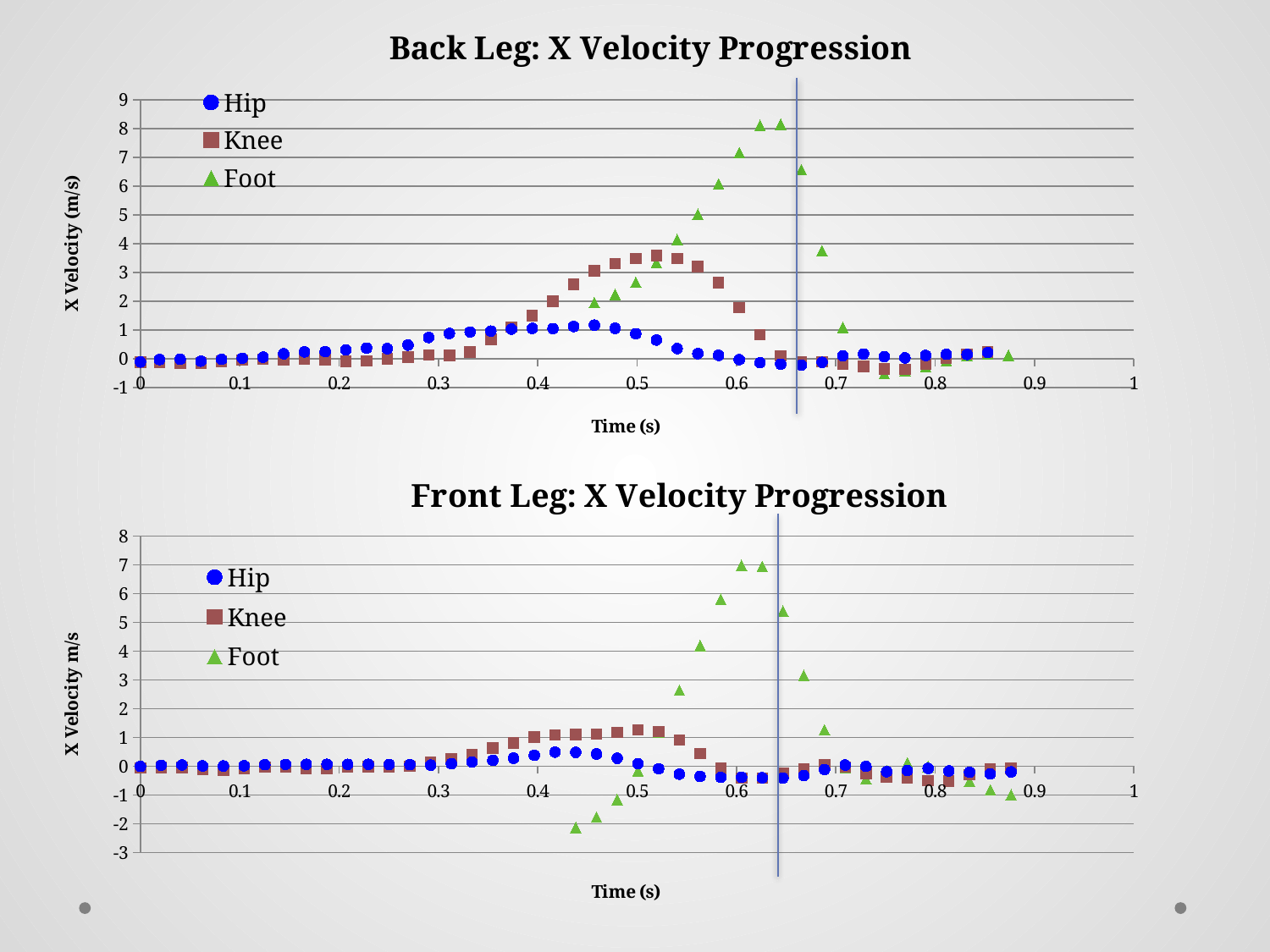
In the Front Leg: X Velocity Progression chart, is the peak value of the Foot series greater or less than 6? greater In the Front Leg: X Velocity Progression chart, which series reaches the highest X velocity? Foot In the Back Leg: X Velocity Progression chart, which series reaches the highest X velocity? Foot In the Back Leg: X Velocity Progression chart, which series has the larger peak value, Knee or Hip? Knee In the Back Leg: X Velocity Progression chart, is the peak value of the Hip series greater or less than 2? less What is the x-axis title of the Front Leg: X Velocity Progression chart? Time (s) In the Back Leg: X Velocity Progression chart, is the peak value of the Knee series greater or less than 3? greater In the Front Leg: X Velocity Progression chart, which series drops to the lowest (most negative) X velocity? Foot How many series does the legend of the Front Leg: X Velocity Progression chart list? 3 What kind of chart is the Back Leg: X Velocity Progression chart? scatter chart